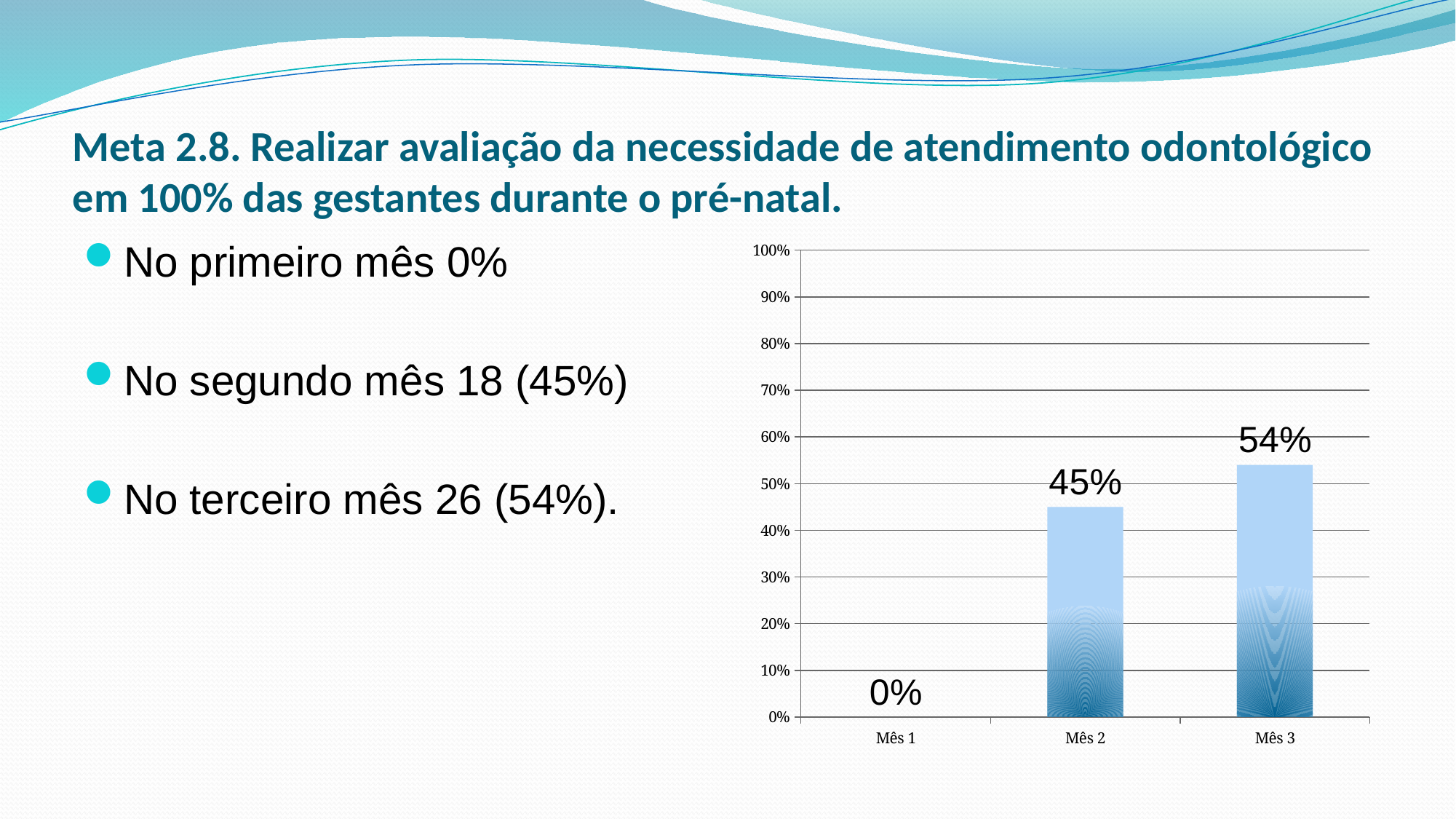
What kind of chart is shown on the slide? bar chart What is the difference between the values for Mês 3 and Mês 2? 9% Do the values rise or fall from Mês 1 to Mês 3? rise Which month has the highest value? Mês 3 Which month has the lowest value? Mês 1 Is the value for Mês 2 greater or less than 50%? less What is the value for Mês 3? 54% What is the value for Mês 2? 45% How many categories are shown on the x axis? 3 What is the value for Mês 1? 0% Is the value for Mês 3 greater or less than 50%? greater Which is larger, the value for Mês 2 or Mês 3? Mês 3